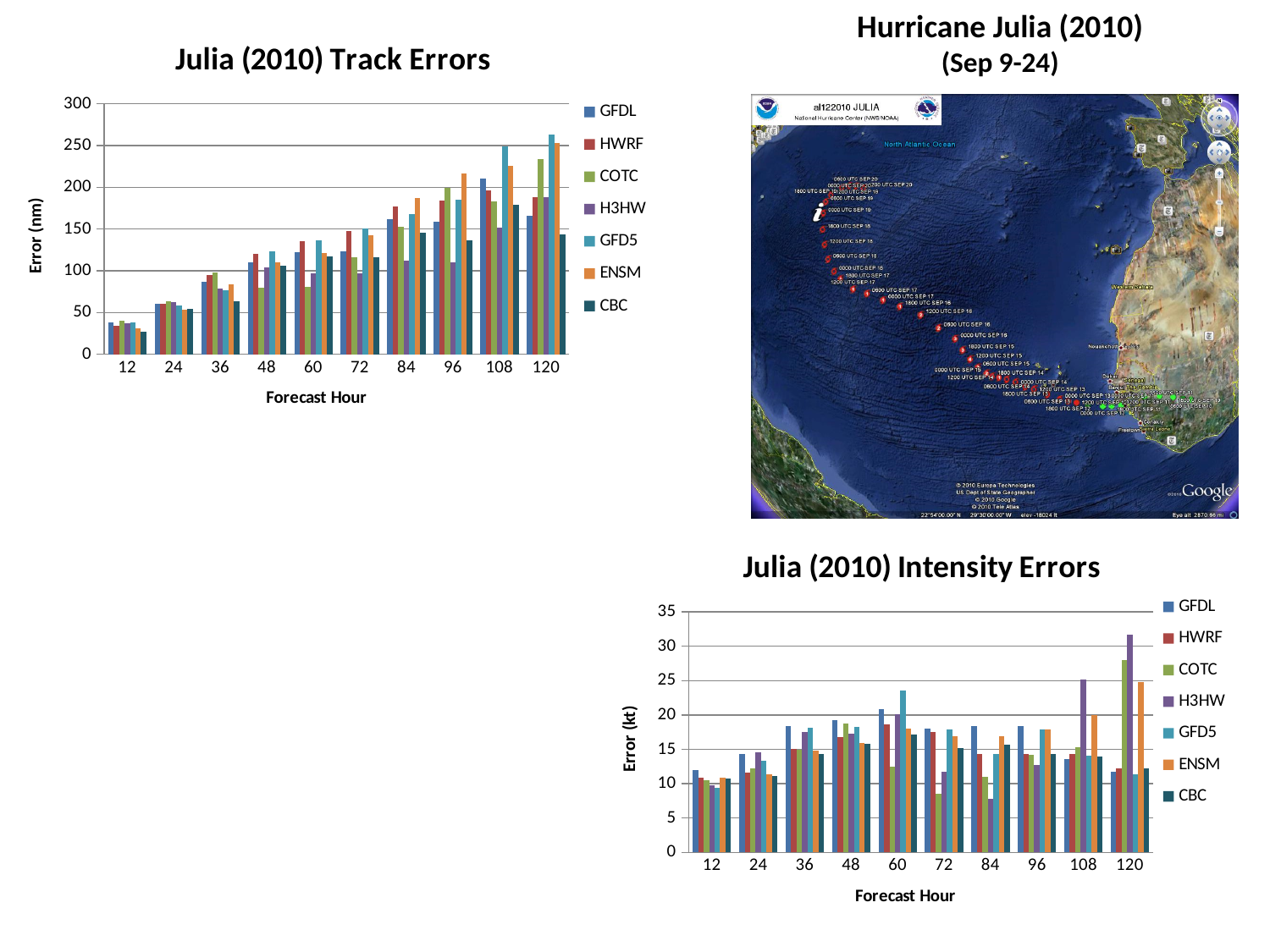
In the Julia (2010) Track Errors chart, do the errors generally rise or fall as the forecast hour increases? rise In the Julia (2010) Track Errors chart, is the value for CBC at forecast hour 96 greater or less than 150? less In the Julia (2010) Track Errors chart, at forecast hour 120, which is larger: GFD5 or CBC? GFD5 In the Julia (2010) Track Errors chart, how many series does the legend list? 7 In the Julia (2010) Track Errors chart, which model has the highest error at forecast hour 120? GFD5 In the Julia (2010) Intensity Errors chart, which model has the highest error at forecast hour 120? H3HW In the Julia (2010) Track Errors chart, is the value for ENSM at forecast hour 108 greater or less than 200? greater In the Julia (2010) Track Errors chart, what kind of chart is shown? bar chart In the Julia (2010) Intensity Errors chart, is the value for COTC at forecast hour 84 greater or less than 10? greater In the Julia (2010) Track Errors chart, how many forecast hours are shown on the x axis? 10 In the Julia (2010) Intensity Errors chart, what is the label of the y axis? Error (kt)